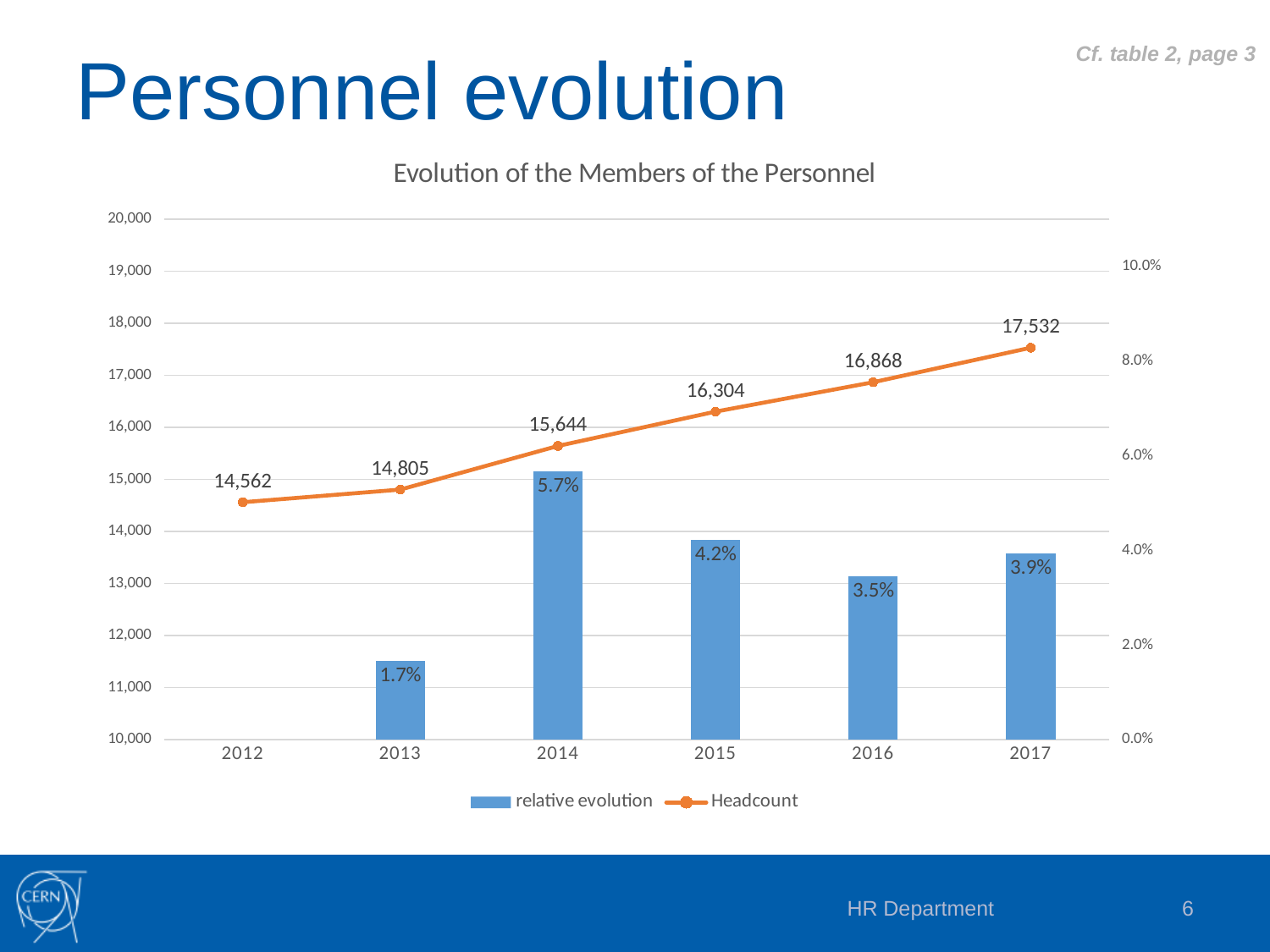
What is the Headcount for 2017? 17,532 How many series does the legend list? 2 How many years are shown on the x axis? 6 What is the Headcount for 2015? 16,304 Which year has the lowest relative evolution among the years with a bar? 2013 What is the relative evolution value for 2014? 5.7% Does the Headcount rise or fall from 2012 to 2017? rise What is the difference in Headcount between 2017 and 2012? 2,970 Is the Headcount for 2014 greater or less than 15,000? greater Which year has the highest relative evolution? 2014 Which is larger, the relative evolution for 2016 or for 2017? 2017 What is the title of the chart? Evolution of the Members of the Personnel